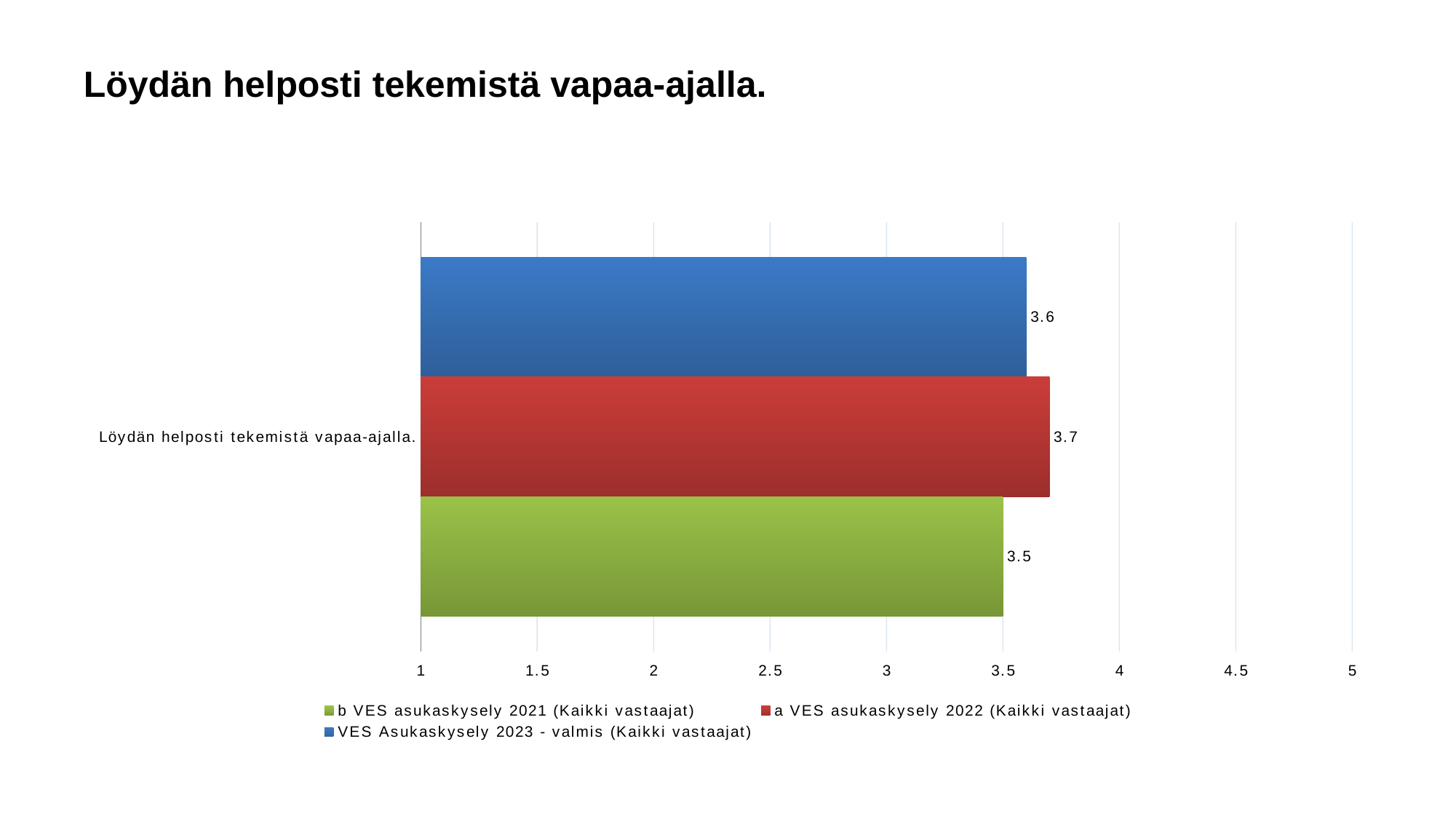
Which series has the highest value? a VES asukaskysely 2022 (Kaikki vastaajat) What is the title of the chart? Löydän helposti tekemistä vapaa-ajalla. What kind of chart is shown on the slide? bar chart What is the difference between the 2022 survey value and the 2023 survey value? 0.1 Which is larger, the value for the 2023 survey or the value for the 2021 survey? 2023 survey What is the difference between the 2022 survey value and the 2021 survey value? 0.2 Which series has the lowest value? b VES asukaskysely 2021 (Kaikki vastaajat) How many series does the legend list? 3 What is the value for the 2021 survey (b VES asukaskysely 2021) series? 3.5 Is the value for the 2022 survey greater or less than 4? less What is the value for the 2023 survey (VES Asukaskysely 2023 - valmis) series? 3.6 What is the value for the 2022 survey (a VES asukaskysely 2022) series? 3.7